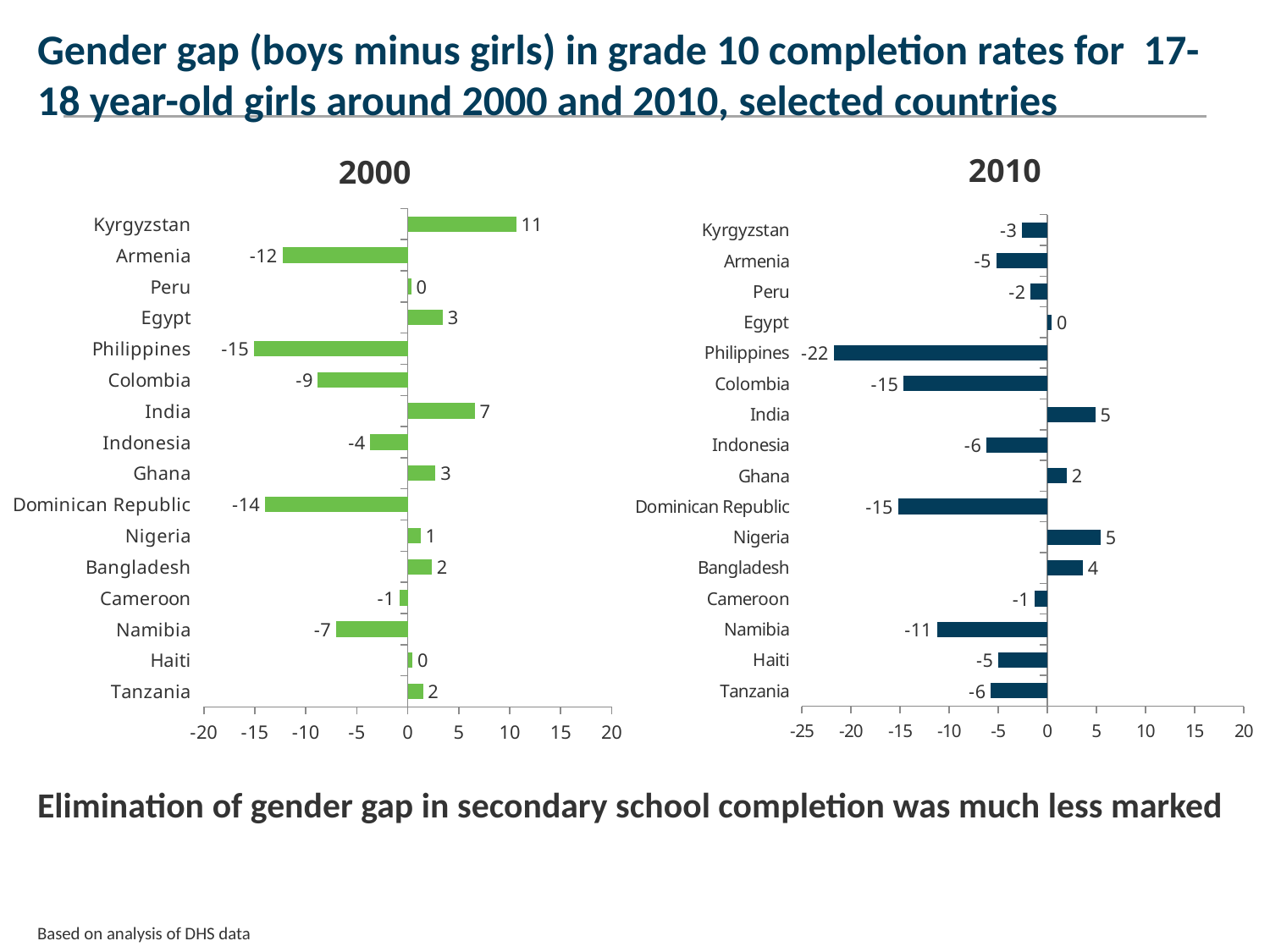
In the 2010 chart, which country has the lowest value? Philippines In the 2000 chart, which country has the highest value? Kyrgyzstan In the 2000 chart, which country has the lowest value? Philippines What colour are the bars in the 2010 chart? dark blue In the 2000 chart, what is the value for the Dominican Republic? -14 In the 2010 chart, what is the value for the Philippines? -22 In the 2000 chart, what is the value for Kyrgyzstan? 11 How many countries are shown in the 2010 chart? 16 In the 2010 chart, what is the value for Namibia? -11 In the 2000 chart, is the value for Armenia larger or smaller than the value for Colombia? smaller What kind of chart is the 2000 chart? bar chart In the 2010 chart, what is the difference between the values for India and Indonesia? 11